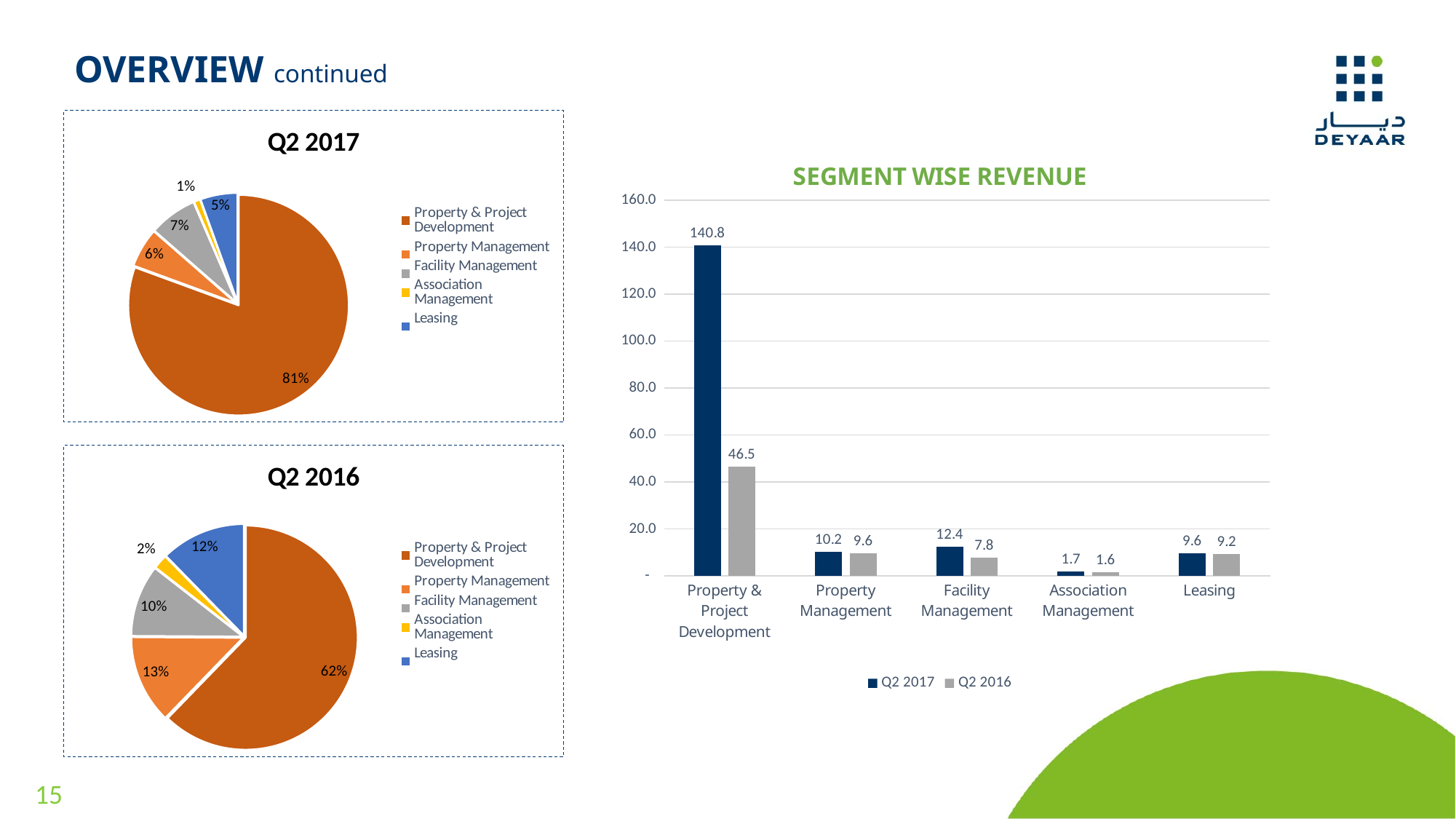
In the Segment Wise Revenue bar chart, what is the difference between the Q2 2017 and Q2 2016 values for Property & Project Development? 94.3 In the Q2 2017 pie chart, what colour is the Leasing slice? Blue In the Segment Wise Revenue bar chart, how many segments are shown on the x axis? 5 In the Q2 2016 pie chart, which segment has the smallest share? Association Management In the Segment Wise Revenue bar chart, what is the Q2 2016 value for Facility Management? 7.8 In the Q2 2017 pie chart, what share does Property & Project Development have? 81% In the Q2 2016 pie chart, what share does Property Management have? 13% In the Segment Wise Revenue bar chart, how many series does the legend list? 2 In the Segment Wise Revenue bar chart, which segment has the lowest Q2 2017 value? Association Management In the Segment Wise Revenue bar chart, what is the Q2 2017 value for Property & Project Development? 140.8 In the Segment Wise Revenue bar chart, which is larger for Leasing: the Q2 2017 value or the Q2 2016 value? Q2 2017 What kind of chart is the Segment Wise Revenue chart? Bar chart